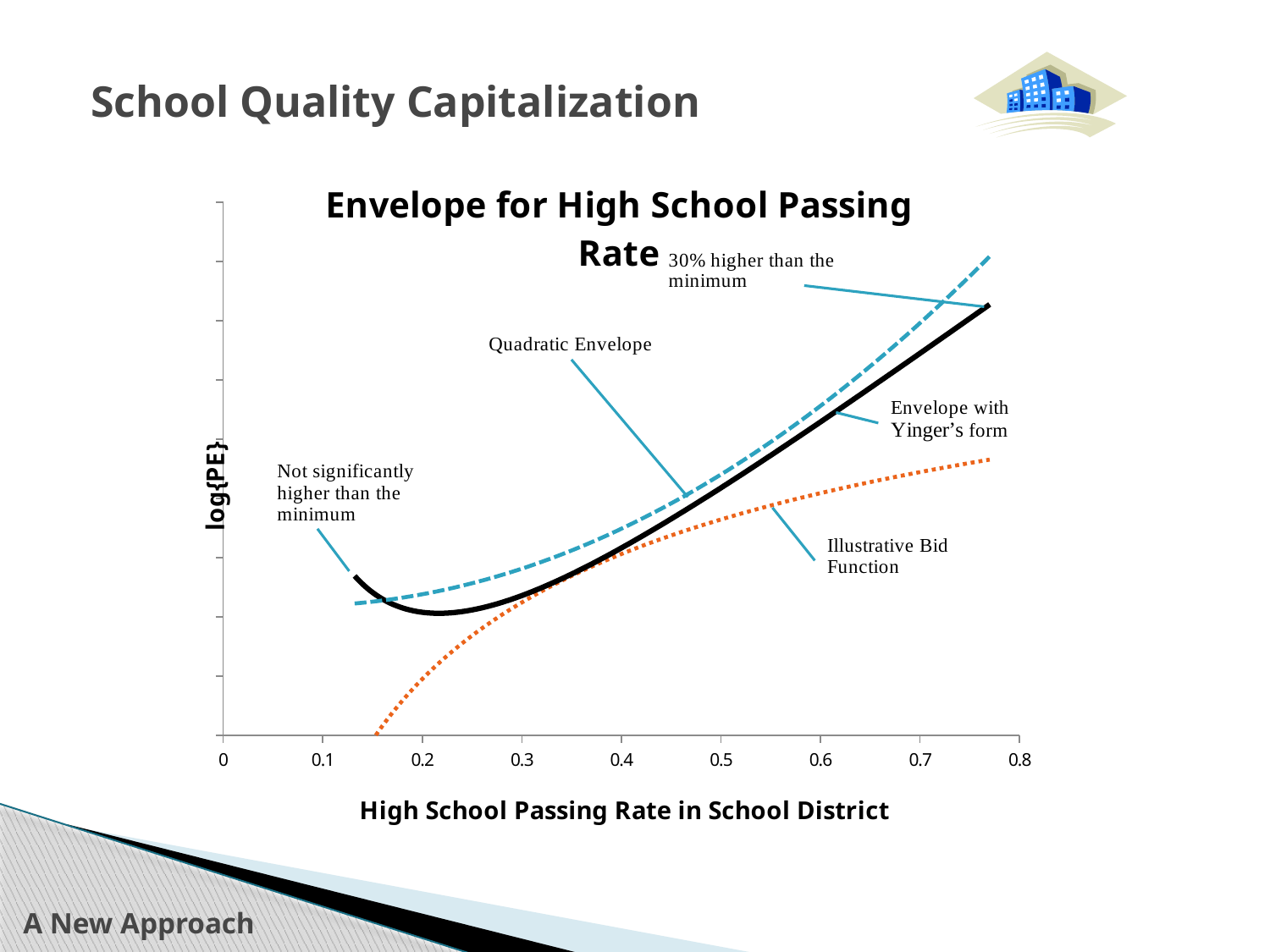
What is the highest value shown on the x axis? 0.8 Does the Illustrative Bid Function rise or fall as the passing rate increases from 0.2 to 0.7? rise At a passing rate of 0.7, which curve is lower: the Envelope with Yinger's form or the Illustrative Bid Function? Illustrative Bid Function Which curve is drawn as an orange dotted line? Illustrative Bid Function At a passing rate of 0.7, which curve is higher: the Quadratic Envelope or the Illustrative Bid Function? Quadratic Envelope What is the label of the x axis? High School Passing Rate in School District According to the annotation, how much higher than the minimum is the right end of the envelope? 30% higher than the minimum How many curves are plotted on the chart? 3 What kind of chart is shown on the slide? line chart Does the Quadratic Envelope curve rise or fall as the passing rate increases from 0.3 to 0.8? rise What is the title of the chart? Envelope for High School Passing Rate Which curve is drawn as a solid black line? Envelope with Yinger's form